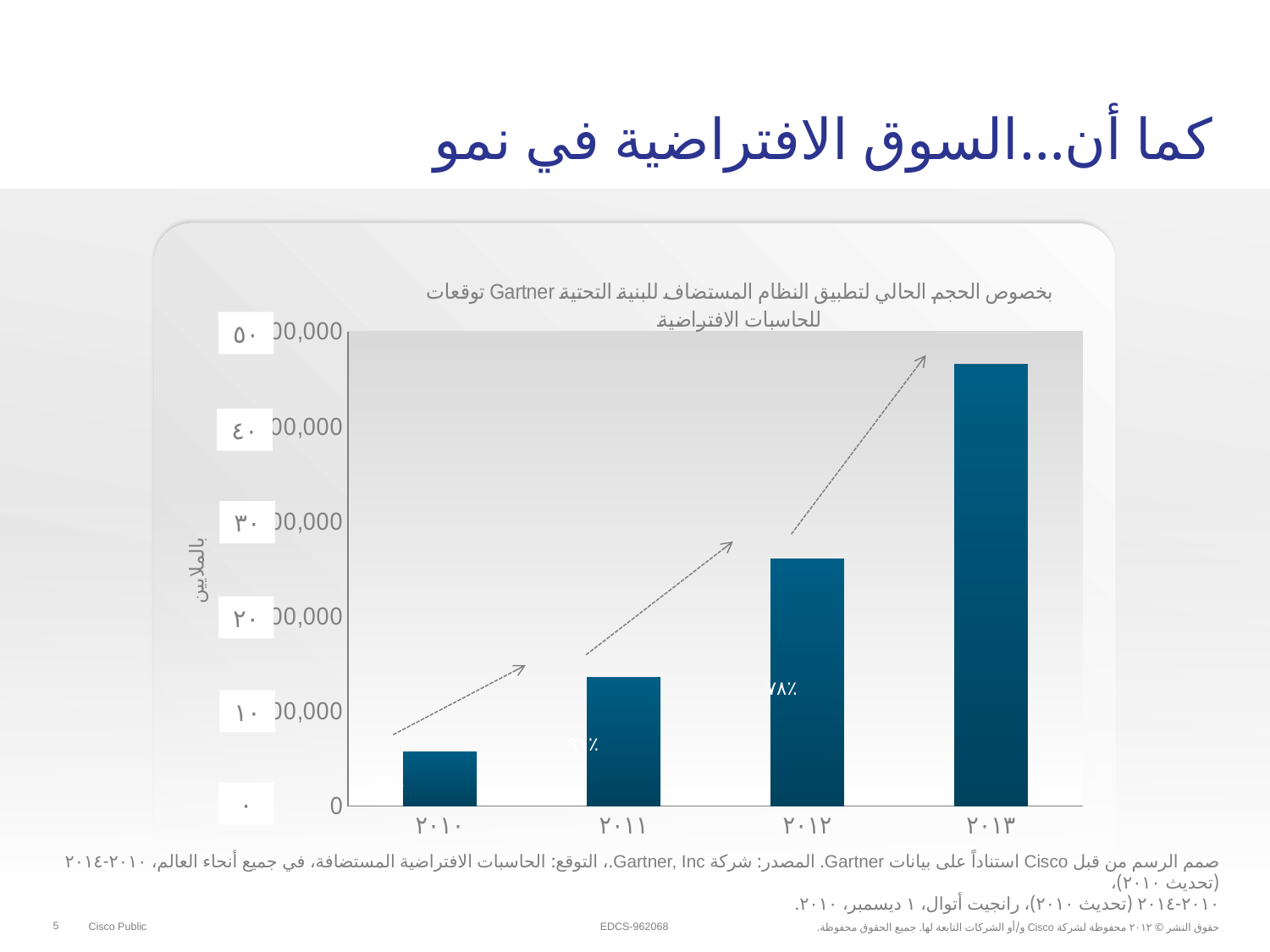
What is the label on the vertical axis? بالملايين How many years (categories) are plotted on the x axis? 4 Is the value for ٢٠١٢ greater or less than ٣٠ million? less Which company's forecasts does the chart title say the data comes from? Gartner Is the value for ٢٠١١ greater or less than ١٠ million? greater Which year has the lowest bar? ٢٠١٠ What kind of chart is shown on the slide? bar chart Which year has the highest bar? ٢٠١٣ Which is larger, the value for ٢٠١١ or the value for ٢٠١٢? ٢٠١٢ Do the values rise or fall from ٢٠١٠ to ٢٠١٣? rise Is the value for ٢٠١٠ greater or less than ١٠ million? less